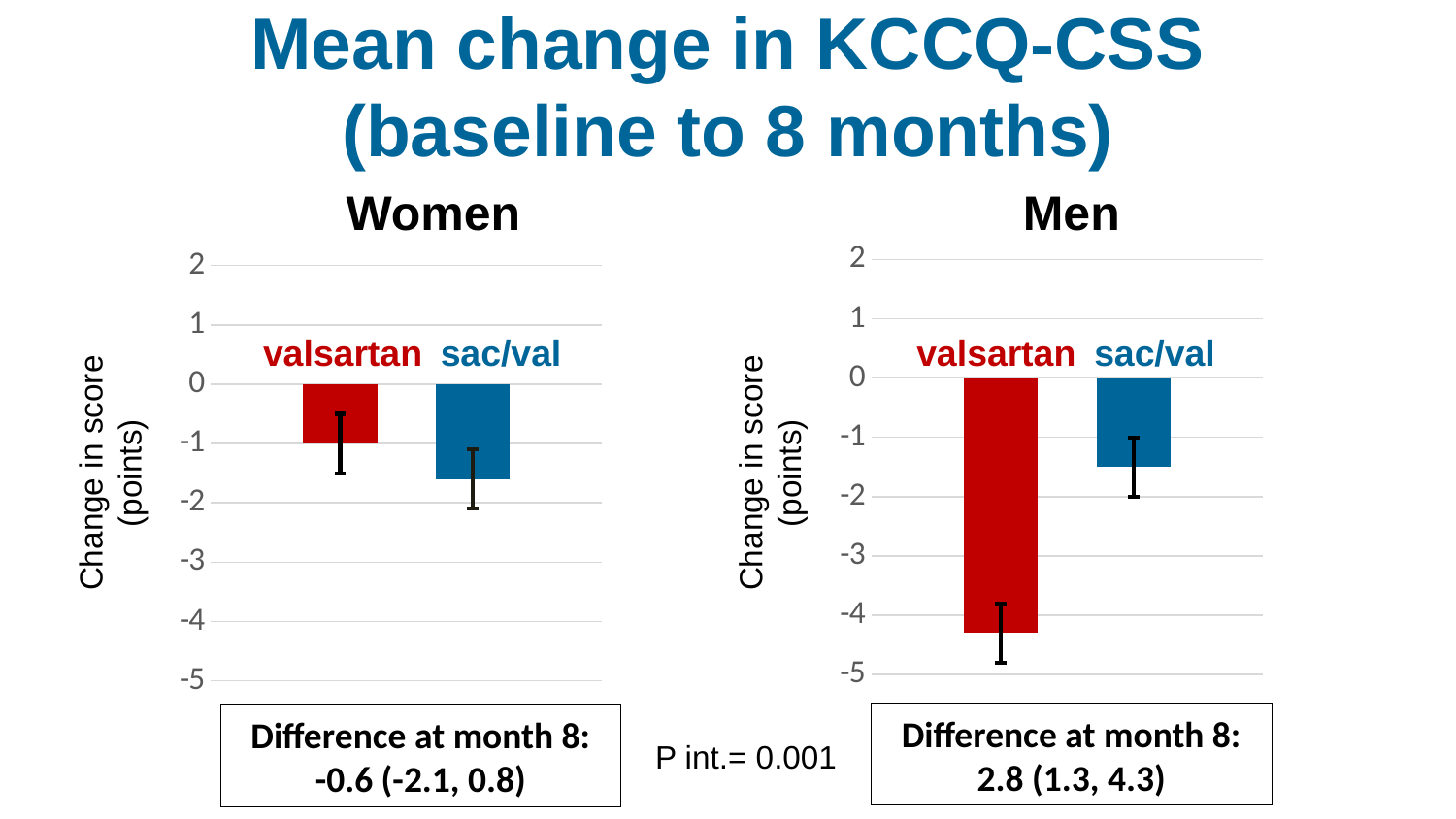
What kind of chart is used for the Women and Men panels on this slide? bar chart In the Men chart, is the value for sac/val greater or less than -1? less In the Men chart, is the value for valsartan greater or less than -4? less In the Men chart, is the value for sac/val greater or less than -2? greater In the Men chart, which treatment shows the larger decrease in KCCQ-CSS score? valsartan What colour are the valsartan bars in both charts? red What P value for interaction is shown between the two charts? P int.= 0.001 In the Women chart, what is the stated difference at month 8 between treatments? -0.6 (-2.1, 0.8) In the Women chart, how many bars are plotted? 2 In the Men chart, what is the stated difference at month 8 between treatments? 2.8 (1.3, 4.3) In the Women chart, which treatment shows the larger decrease in KCCQ-CSS score? sac/val